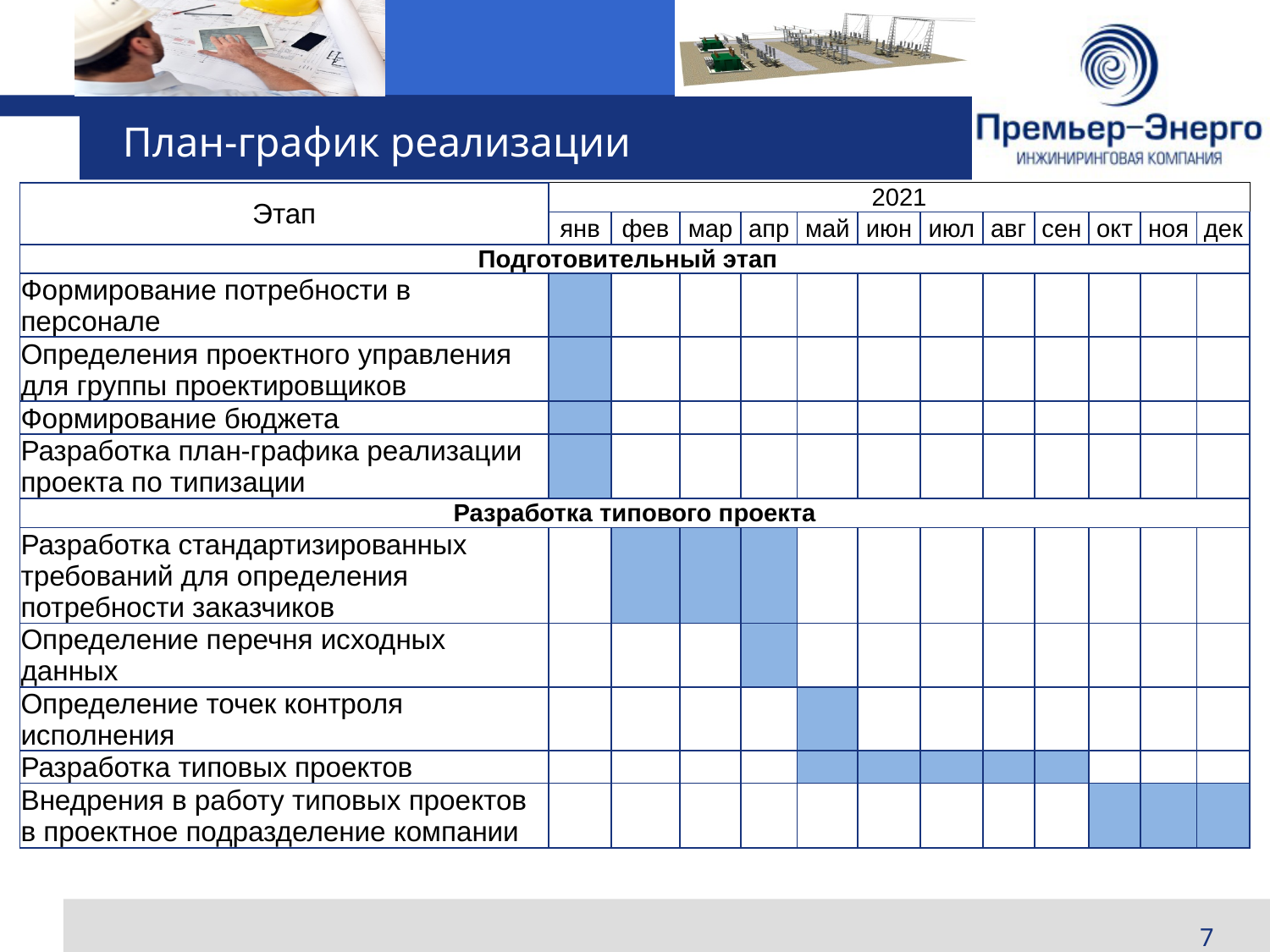
In which month is 'Формирование бюджета' scheduled? янв What is the title of the slide chart? План-график реализации Which months does 'Разработка стандартизированных требований для определения потребности заказчиков' span? фев, мар, апр Which task spans the largest number of months? Разработка типовых проектов Which task lasts longer: 'Определение перечня исходных данных' or 'Внедрения в работу типовых проектов в проектное подразделение компании'? Внедрения в работу типовых проектов в проектное подразделение компании How many months does 'Разработка типовых проектов' span? 5 In which month is 'Определение точек контроля исполнения' scheduled? май Which year does the schedule chart cover? 2021 How many tasks are listed under 'Подготовительный этап'? 4 What kind of chart is shown on the slide? Gantt chart How many tasks (rows) are scheduled in the chart in total? 9 How many months are shown along the top of the schedule chart? 12